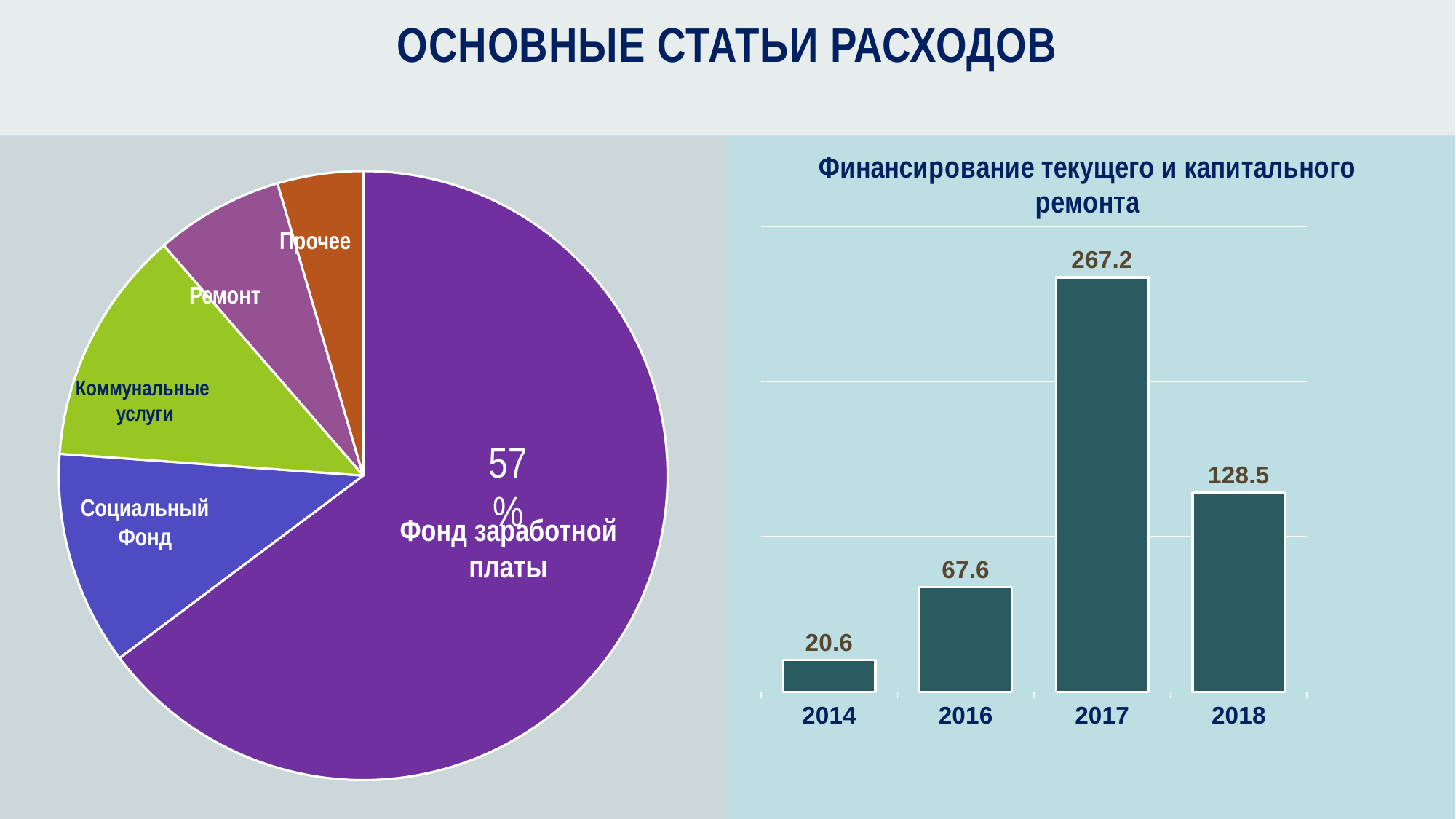
In the pie chart on the left, what share does 'Фонд заработной платы' have? 57% In the bar chart titled 'Финансирование текущего и капитального ремонта', what is the value for 2014? 20.6 In the bar chart titled 'Финансирование текущего и капитального ремонта', what is the value for 2017? 267.2 How many slices does the pie chart on the left have? 5 In the bar chart on the right, what is the difference between the values for 2016 and 2014? 47 How many years are shown in the bar chart on the right? 4 In the bar chart on the right, which year has the highest value? 2017 In the bar chart on the right, which year has the lowest value? 2014 In the bar chart on the right, what is the difference between the values for 2017 and 2018? 138.7 In the pie chart on the left, which category has the largest slice? Фонд заработной платы In the bar chart on the right, which is larger: the value for 2018 or the value for 2016? 2018 What kind of chart is the chart on the right side of the slide? bar chart